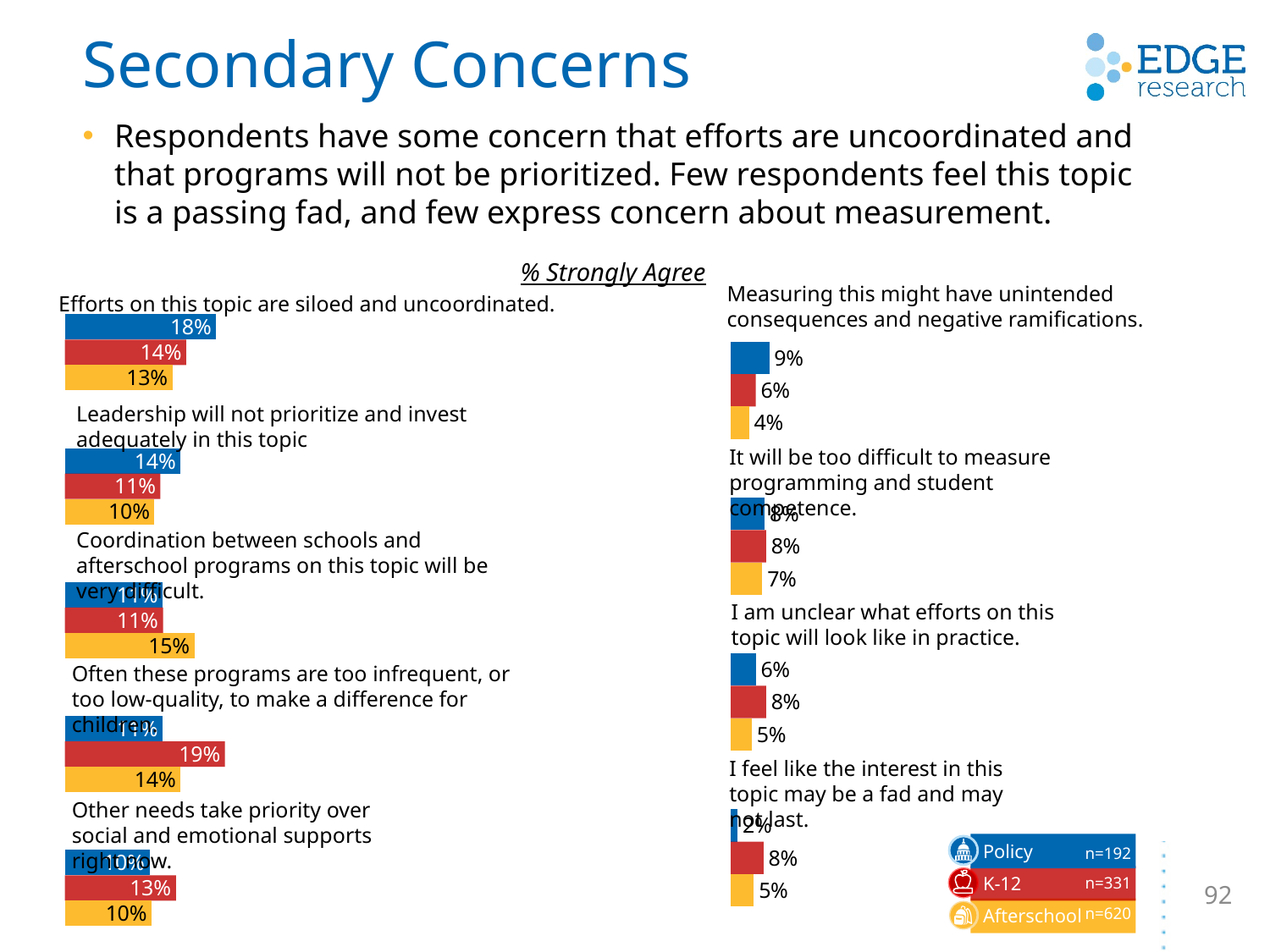
In the chart 'Efforts on this topic are siloed and uncoordinated', what is the difference between the Policy and K-12 values? 4% In the chart 'Measuring this might have unintended consequences and negative ramifications', what is the difference between the Policy and Afterschool values? 5% In the chart 'Often these programs are too infrequent, or too low-quality, to make a difference for children', what is the K-12 value? 19% In the chart 'Coordination between schools and afterschool programs on this topic will be very difficult', what is the Afterschool value? 15% In the chart 'I am unclear what efforts on this topic will look like in practice', is the K-12 value larger or smaller than the Policy value? larger In the chart 'Efforts on this topic are siloed and uncoordinated', what is the value for Afterschool? 13% In the chart 'Efforts on this topic are siloed and uncoordinated', what percentage of Policy respondents strongly agree? 18% In the chart 'Measuring this might have unintended consequences and negative ramifications', which group has the highest value? Policy What type of chart is used on this slide? bar chart In the chart 'I feel like the interest in this topic may be a fad and may not last', what is the Policy value? 2% How many groups does the legend list? 3 In the chart 'Leadership will not prioritize and invest adequately in this topic', which group has the lowest value? Afterschool